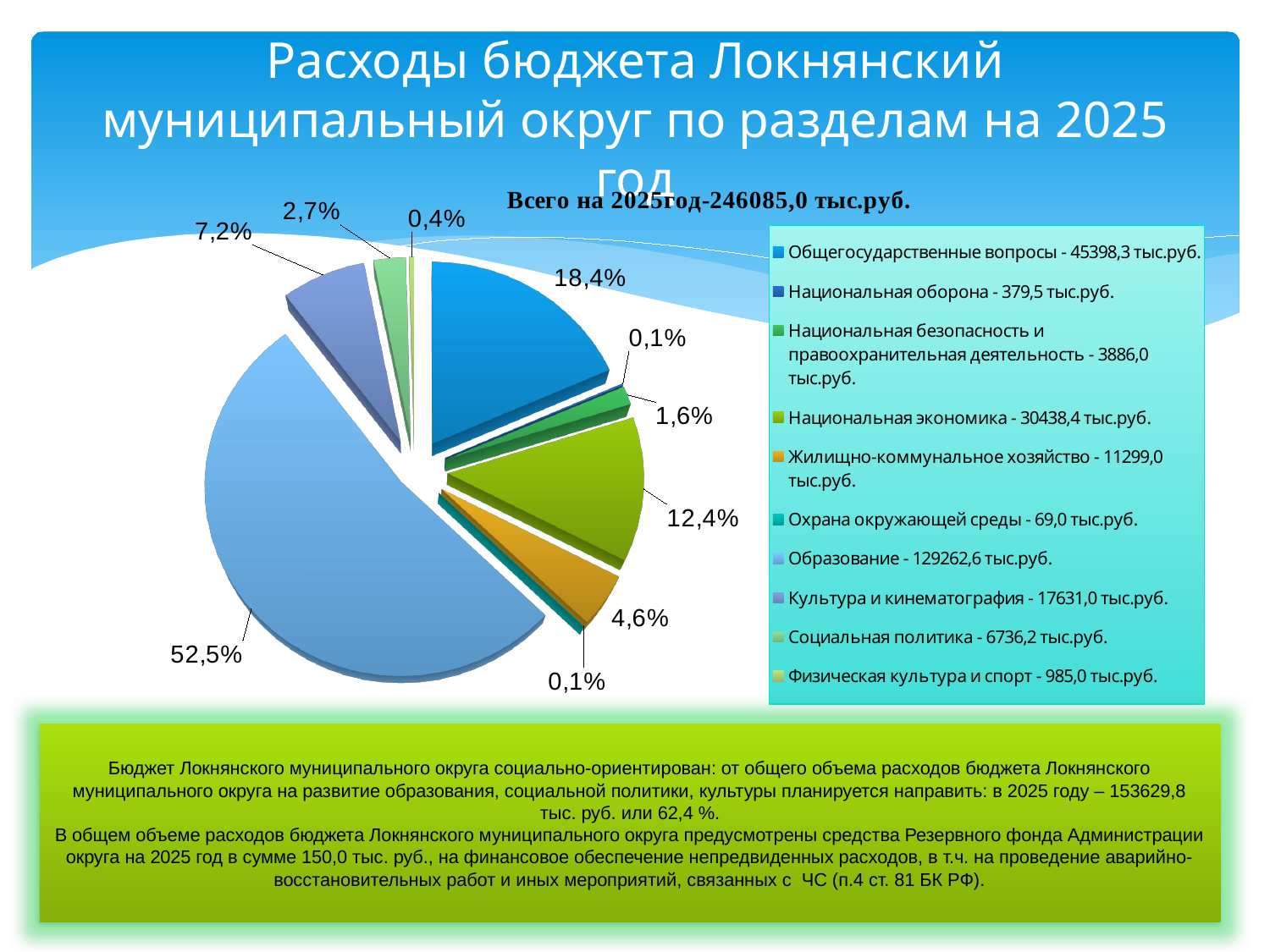
Which category has the largest slice of the pie? Образование According to the legend, what is the amount for Национальная оборона? 379,5 тыс.руб. What kind of chart is shown on the slide? pie chart What share of the pie does Образование take? 52,5% What share of the pie does Национальная экономика take? 12,4% What share of the pie does Культура и кинематография take? 7,2% According to the legend, what is the amount for Жилищно-коммунальное хозяйство? 11299,0 тыс.руб. According to the legend, which category has the smallest amount in тыс.руб.? Охрана окружающей среды How many categories does the legend of the pie chart list? 10 Which slice is larger: Национальная экономика or Жилищно-коммунальное хозяйство? Национальная экономика What is the difference in percentage points between the Образование slice (52,5%) and the Общегосударственные вопросы slice (18,4%)? 34,1%